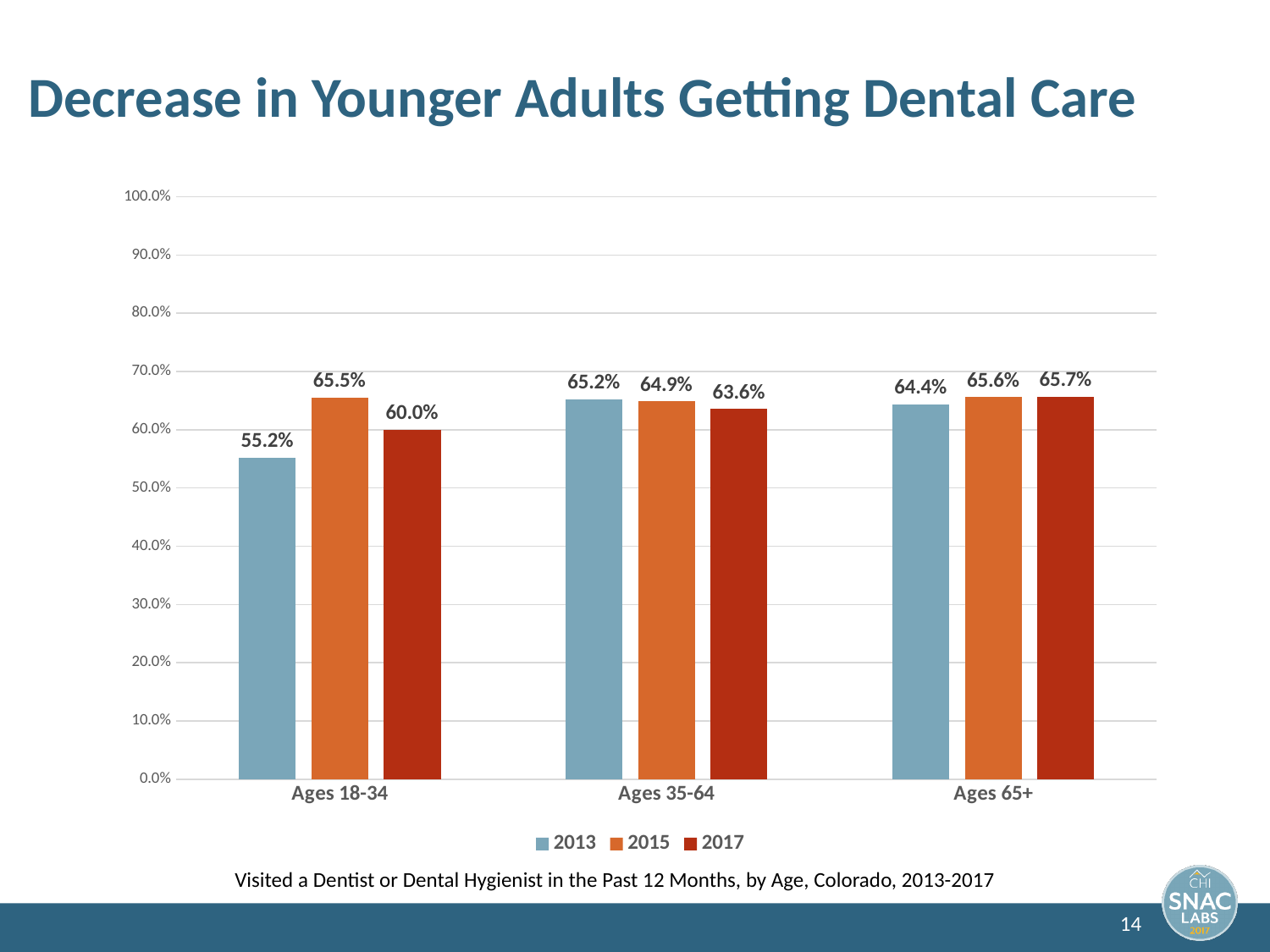
What is the difference between the 2013 and 2017 values for Ages 35-64? 1.6% Which age group has the lowest value in 2013? Ages 18-34 How many series does the legend list? 3 What is the value for Ages 65+ in 2017? 65.7% What kind of chart is shown on the slide? Bar chart Which age group has the lowest value in 2017? Ages 18-34 What is the difference between the 2015 and 2017 values for Ages 18-34? 5.5% What is the value for Ages 35-64 in 2015? 64.9% Which is larger for Ages 18-34: the 2013 value or the 2017 value? 2017 Do the values for Ages 35-64 rise or fall from 2013 to 2017? Fall How many age groups are shown on the x axis? 3 What is the value for Ages 18-34 in 2013? 55.2%